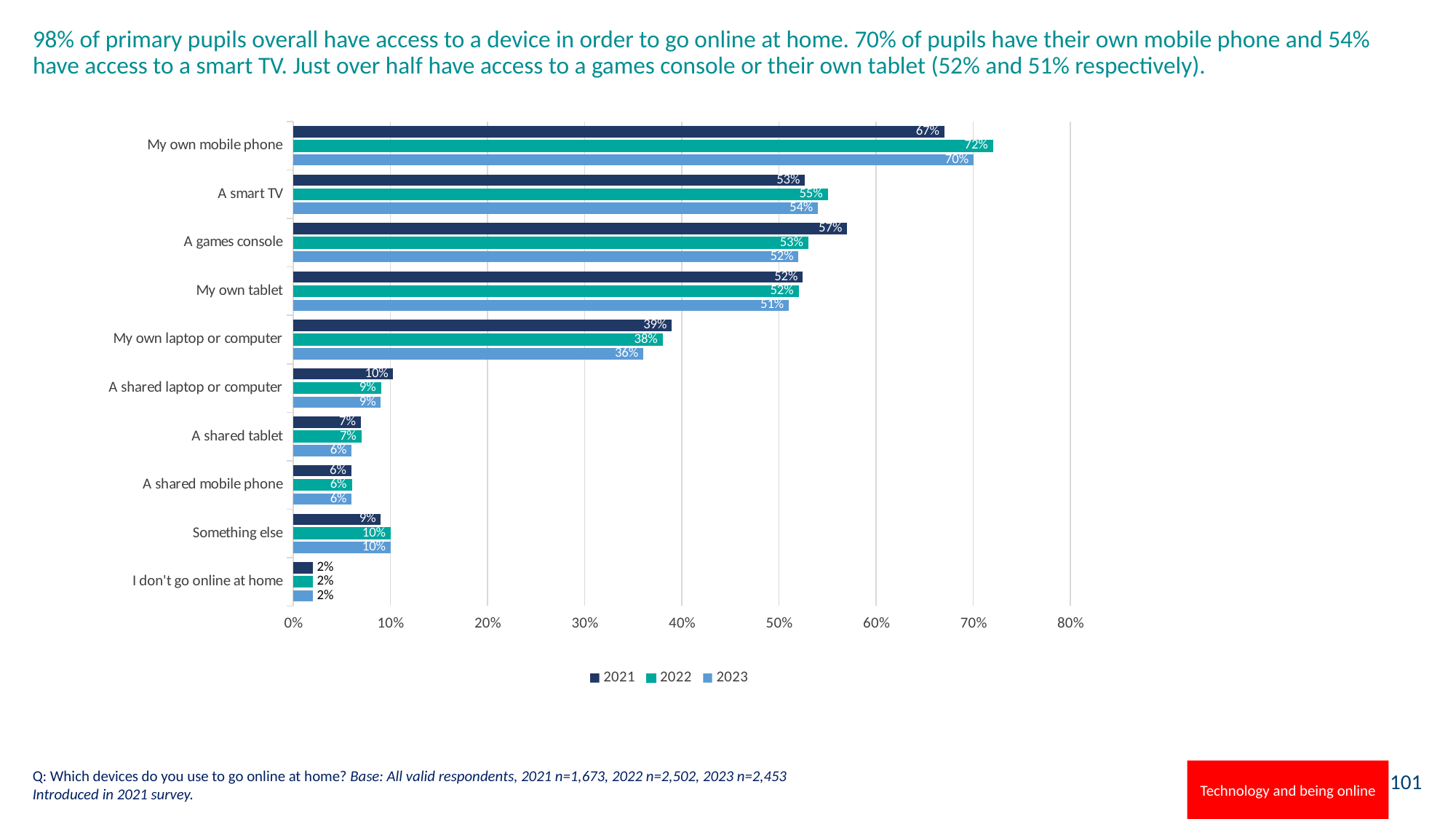
How many device categories are shown on the chart? 10 Which category has the highest 2022 value? My own mobile phone Which category has the lowest 2023 value? I don't go online at home What kind of chart is shown on the slide? Bar chart What is the 2021 value for 'A games console'? 57% Is the 2023 value for 'My own laptop or computer' greater or less than 40%? less What is the 2022 value for 'My own laptop or computer'? 38% Which is larger: the 2021 value for 'A games console' or the 2021 value for 'A smart TV'? A games console What is the 2023 value for 'My own mobile phone'? 70% Which years are listed in the chart legend? 2021, 2022, 2023 How many series does the legend list? 3 What is the difference between the 2022 and 2021 values for 'My own mobile phone'? 5%